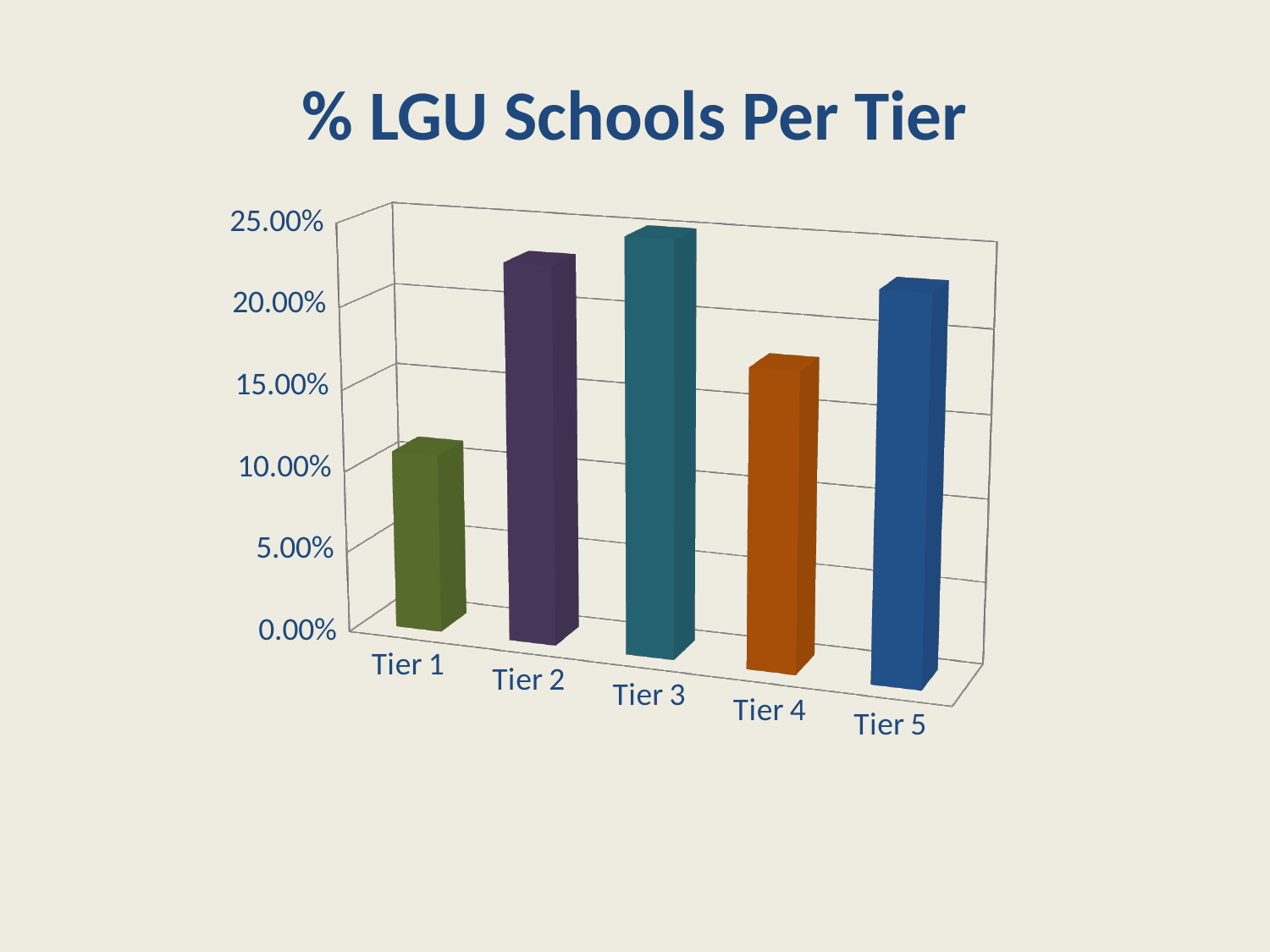
Which tier has the highest percentage of LGU schools? Tier 3 Is the value for Tier 5 greater or less than 20.00%? greater Is the value for Tier 4 greater or less than 20.00%? less Is the value for Tier 4 greater or less than 15.00%? greater What is the title of the chart? % LGU Schools Per Tier Which is larger, the value for Tier 3 or the value for Tier 4? Tier 3 How many tiers (categories) are shown on the x axis? 5 What type of chart is shown on the slide? Bar chart Which tier has the lowest percentage of LGU schools? Tier 1 Which is larger, the value for Tier 4 or the value for Tier 1? Tier 4